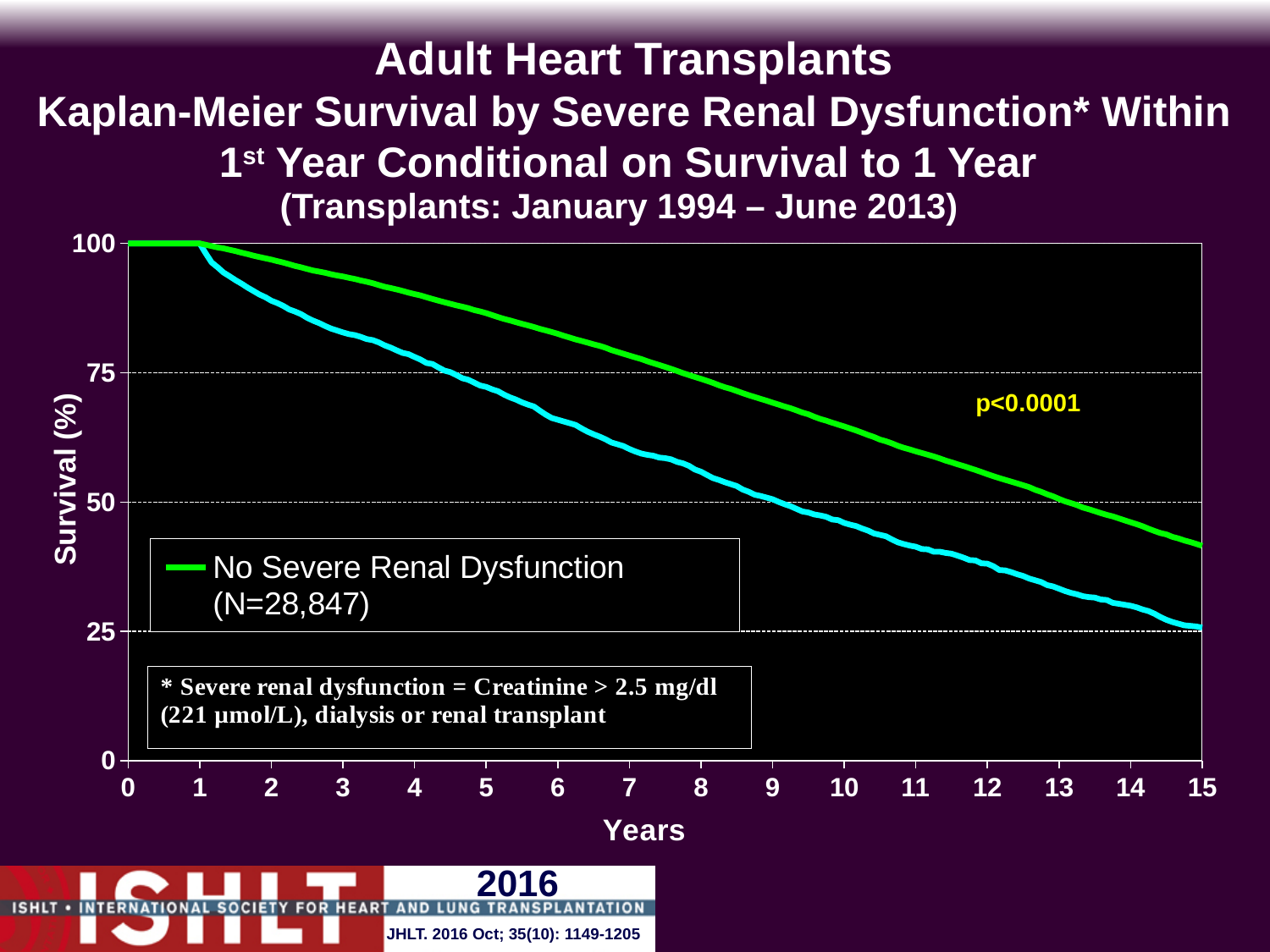
Is the survival value for the cyan line at year 6 greater or less than 75? less Is the survival value for the cyan line at year 10 greater or less than 50? less What is the N for the No Severe Renal Dysfunction group in the legend? 28,847 What is the survival value for the No Severe Renal Dysfunction line at year 0? 100 What kind of chart is shown on the slide? line chart Is the survival value for the No Severe Renal Dysfunction line at year 15 greater or less than 50? less Does survival rise or fall as the years increase along the x axis? fall What is the highest value shown on the Years axis? 15 What p-value is shown on the chart? p<0.0001 Which line is higher at year 10, the green line or the cyan line? green